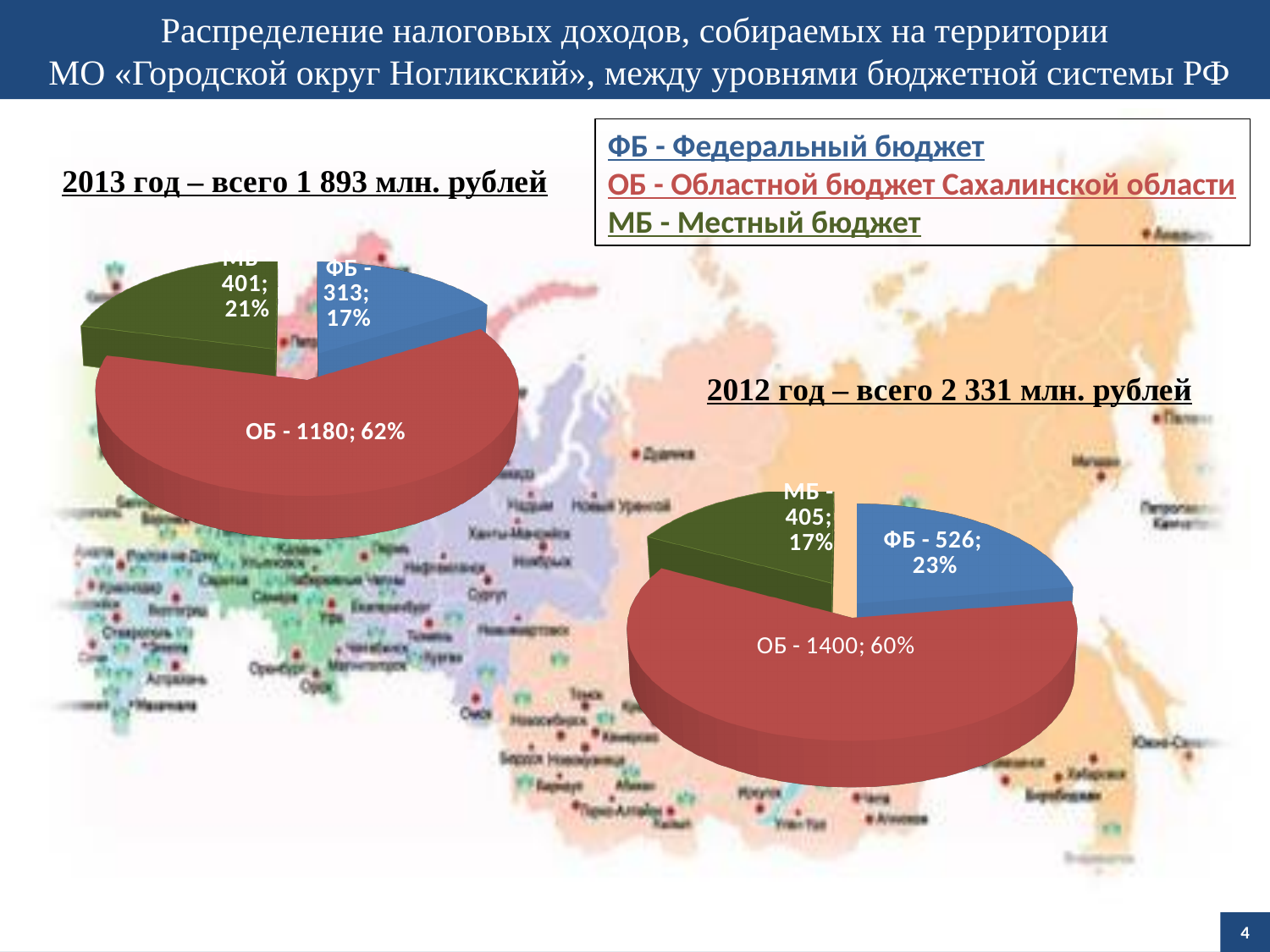
In the 2013 chart, what share of the pie does ФБ have? 17% In the 2013 chart, which category has the largest slice? ОБ In the 2012 chart ("2012 год – всего 2 331 млн. рублей"), what value is shown for ФБ? 526; 23% How many slices does the 2012 pie chart have? 3 In the 2013 chart, which category has the smallest slice? ФБ What kind of chart is used for the 2013 data ("2013 год – всего 1 893 млн. рублей")? pie chart In the 2012 chart, what is the difference between the ОБ value and the МБ value? 995 In the 2013 chart, what is the difference between the ОБ value and the ФБ value? 867 In the 2012 chart, what share of the pie does ОБ have? 60% In the 2012 chart, which is larger, ФБ or МБ? ФБ In the 2013 chart, what value is shown for МБ? 401; 21% In the 2013 chart, what value is shown for ОБ? 1180; 62%